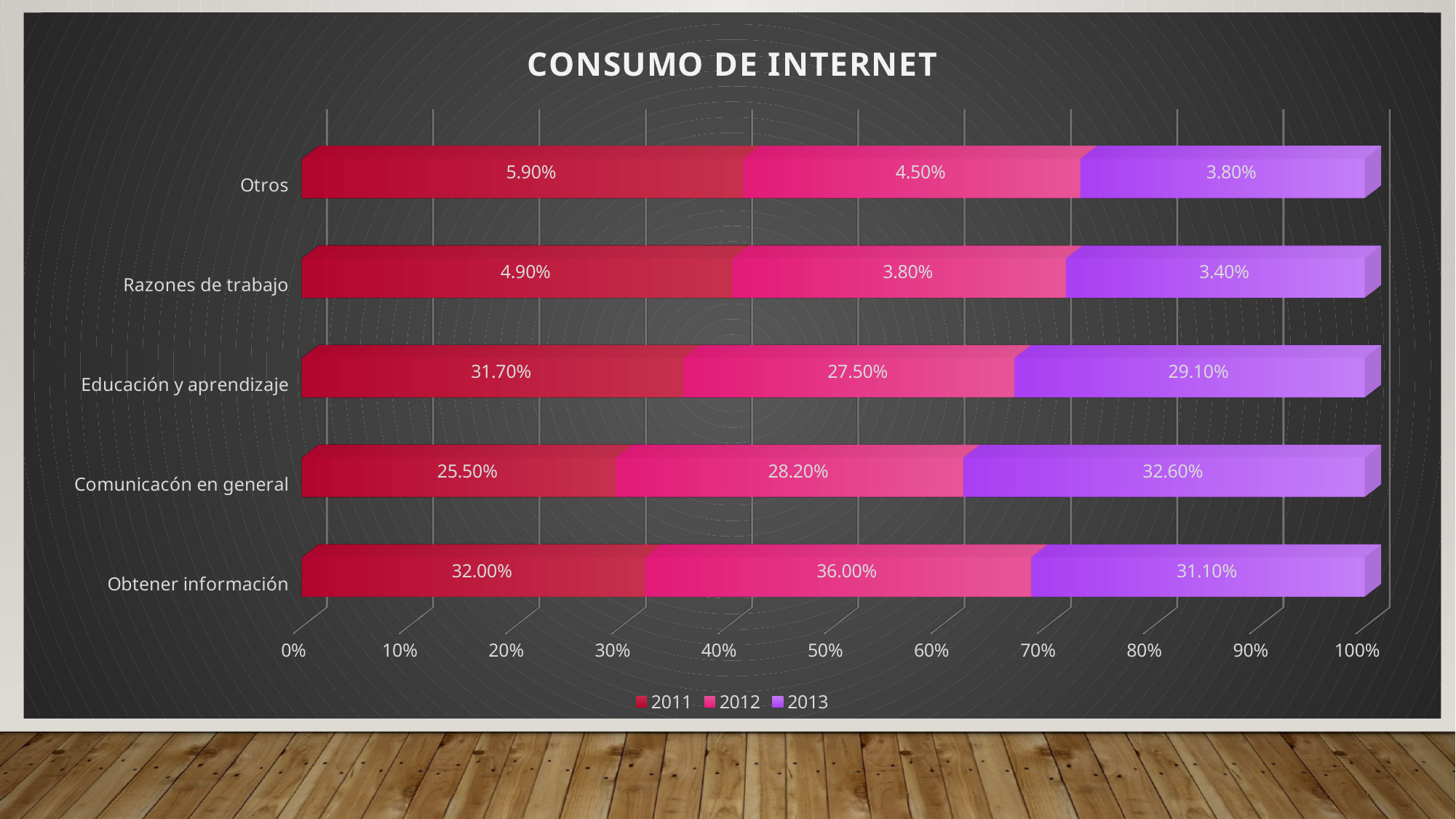
What kind of chart is shown on the slide? Stacked bar chart How many series does the legend list? 3 For Razones de trabajo, which is larger: the 2011 value or the 2012 value? 2011 What is the 2013 value for Comunicacón en general? 32.60% What is the 2012 value for Educación y aprendizaje? 27.50% What is the 2012 value for Obtener información? 36.00% What is the title of the chart? CONSUMO DE INTERNET Which category has the lowest value in the 2012 series? Razones de trabajo Which category has the highest value in the 2013 series? Comunicacón en general How many categories are shown on the chart? 5 For Comunicacón en general, what is the difference between the 2013 value and the 2011 value? 7.10% What is the value for Otros in the 2011 series? 5.90%